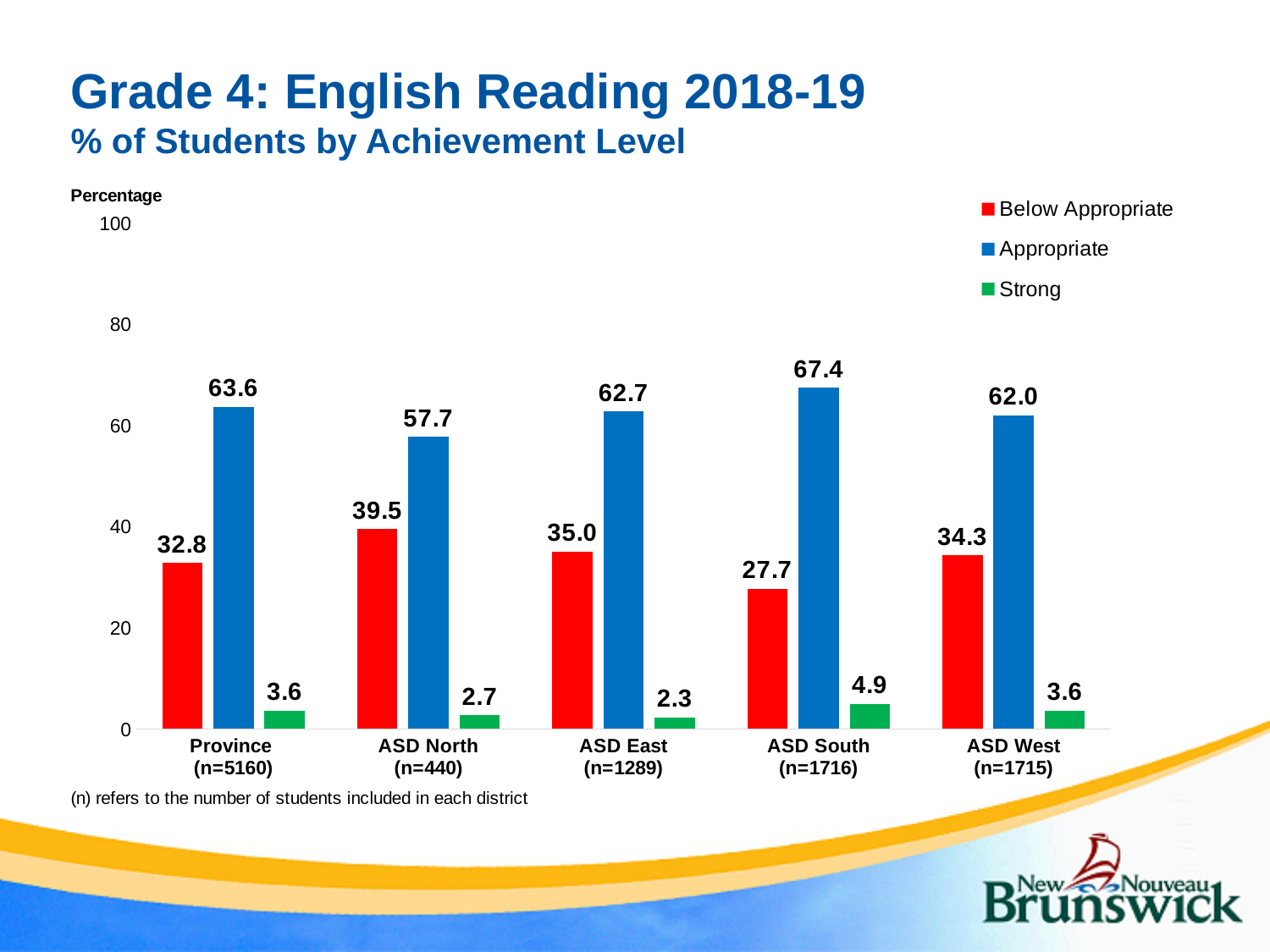
What kind of chart is shown on the slide? Bar chart What is the Below Appropriate percentage for ASD North? 39.5 What is the difference between the Appropriate percentages for Province and ASD North? 5.9 Which category has the lowest Below Appropriate percentage? ASD South Which colour represents the Strong series in the legend? Green Which is larger, the Below Appropriate percentage for ASD East or for ASD West? ASD East What is the Strong percentage for ASD East? 2.3 How many categories are shown on the x axis? 5 Which district has the highest Appropriate percentage? ASD South Which category has the lowest Strong percentage? ASD East How many series does the legend list? 3 What is the Appropriate percentage for ASD South? 67.4